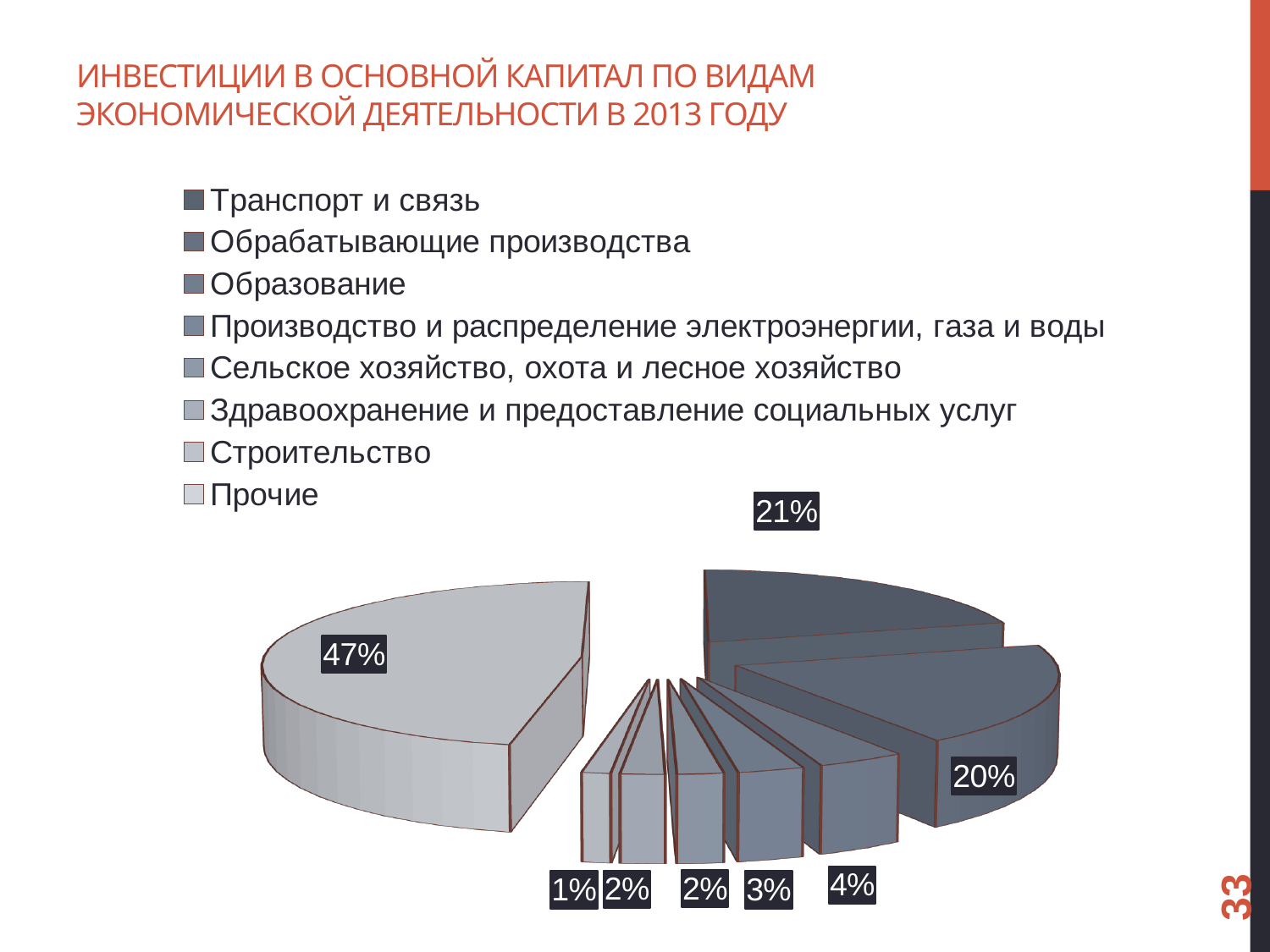
What is the largest share shown on the pie chart? 47% What share of the pie chart does the 'Обрабатывающие производства' slice have? 20% What share of the pie chart does the 'Транспорт и связь' slice have? 21% How many categories does the legend of the pie chart list? 8 What kind of chart is shown on the slide? pie chart What year does the chart title refer to? 2013 Which legend entry is listed first in the pie chart's legend? Транспорт и связь What is the smallest share shown on the pie chart? 1% What share of the pie chart does the 'Прочие' slice have? 47% Which slice is larger: 'Прочие' or 'Транспорт и связь'? Прочие How many slices of the pie chart are labelled with 2%? 2 By how many percentage points does the 47% slice exceed the 21% slice? 26